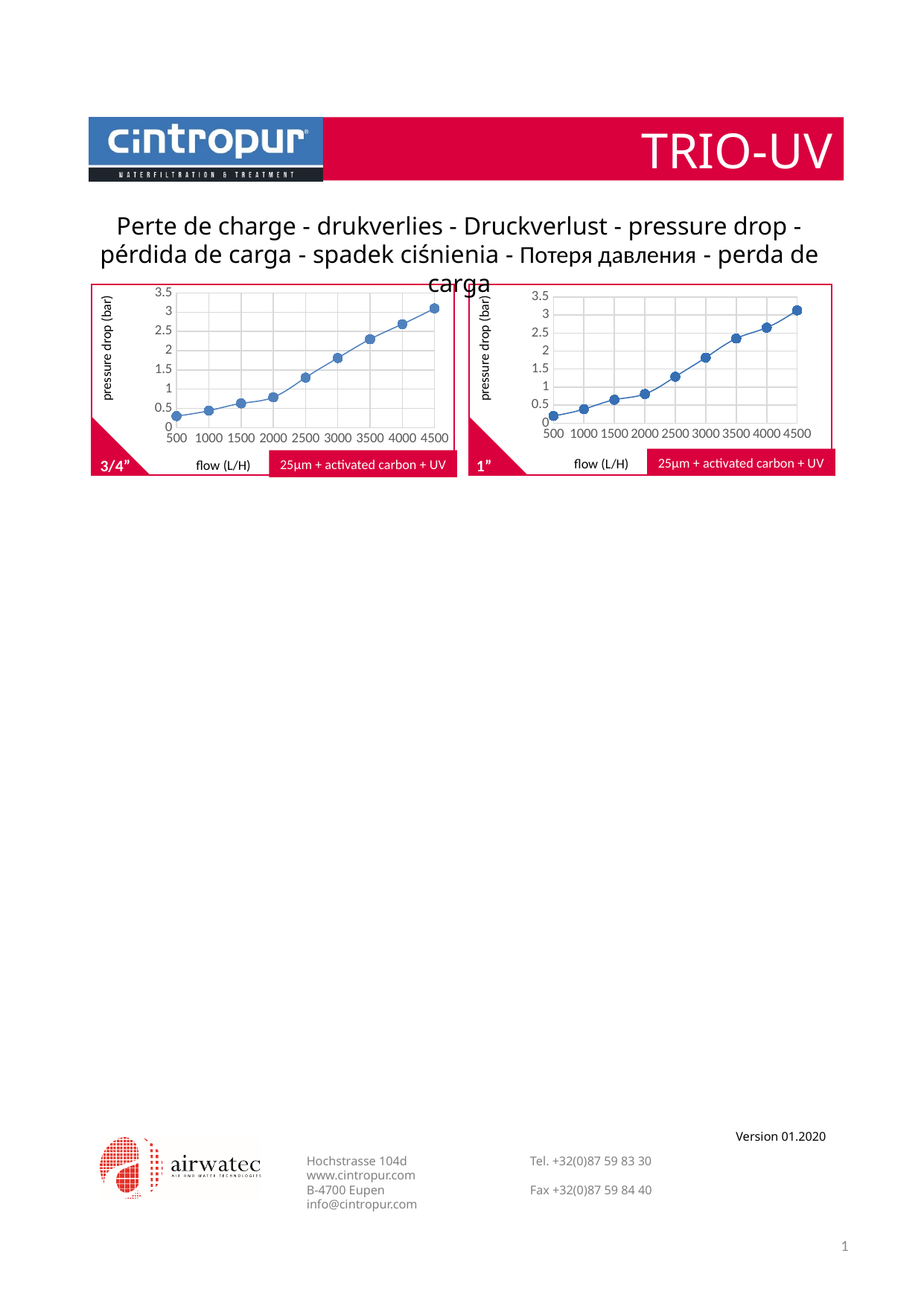
On the 3/4" chart on the left, is the pressure drop at 3000 L/H greater or less than 1.5 bar? greater What kind of chart is the 3/4" chart on the left? line chart On the 1" chart on the right, does the pressure drop rise or fall as flow increases? rise On the 1" chart on the right, is the pressure drop at 2500 L/H greater or less than 1 bar? greater On the 1" chart on the right, is the pressure drop at 3500 L/H greater or less than 2 bar? greater How many data points are plotted on the 1" chart on the right? 9 What is the label of the x axis on the 3/4" chart on the left? flow (L/H) On the 3/4" chart on the left, does the pressure drop rise or fall as flow increases? rise What is the label of the y axis on the 1" chart on the right? pressure drop (bar)